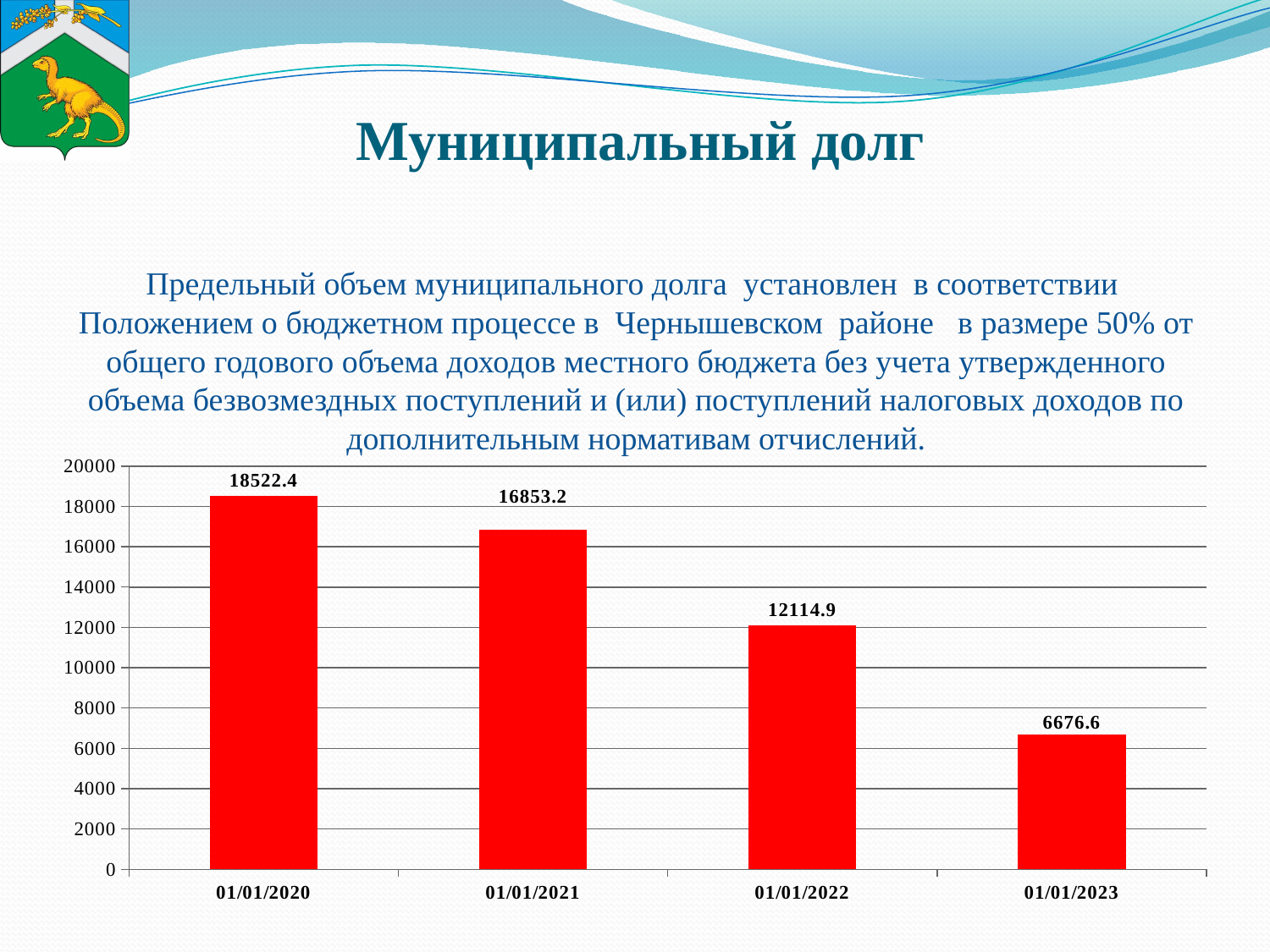
Which is larger, the value for 01/01/2021 or the value for 01/01/2022? 01/01/2021 Which date has the lowest value? 01/01/2023 Which date has the highest value? 01/01/2020 How many bars are shown in the chart? 4 What is the value for 01/01/2020? 18522.4 Do the values rise or fall from 01/01/2020 to 01/01/2023? Fall What kind of chart is shown on the slide? Bar chart What is the value for 01/01/2023? 6676.6 What is the difference between the values for 01/01/2020 and 01/01/2021? 1669.2 What is the value for 01/01/2021? 16853.2 What is the value for 01/01/2022? 12114.9 What is the difference between the values for 01/01/2022 and 01/01/2023? 5438.3